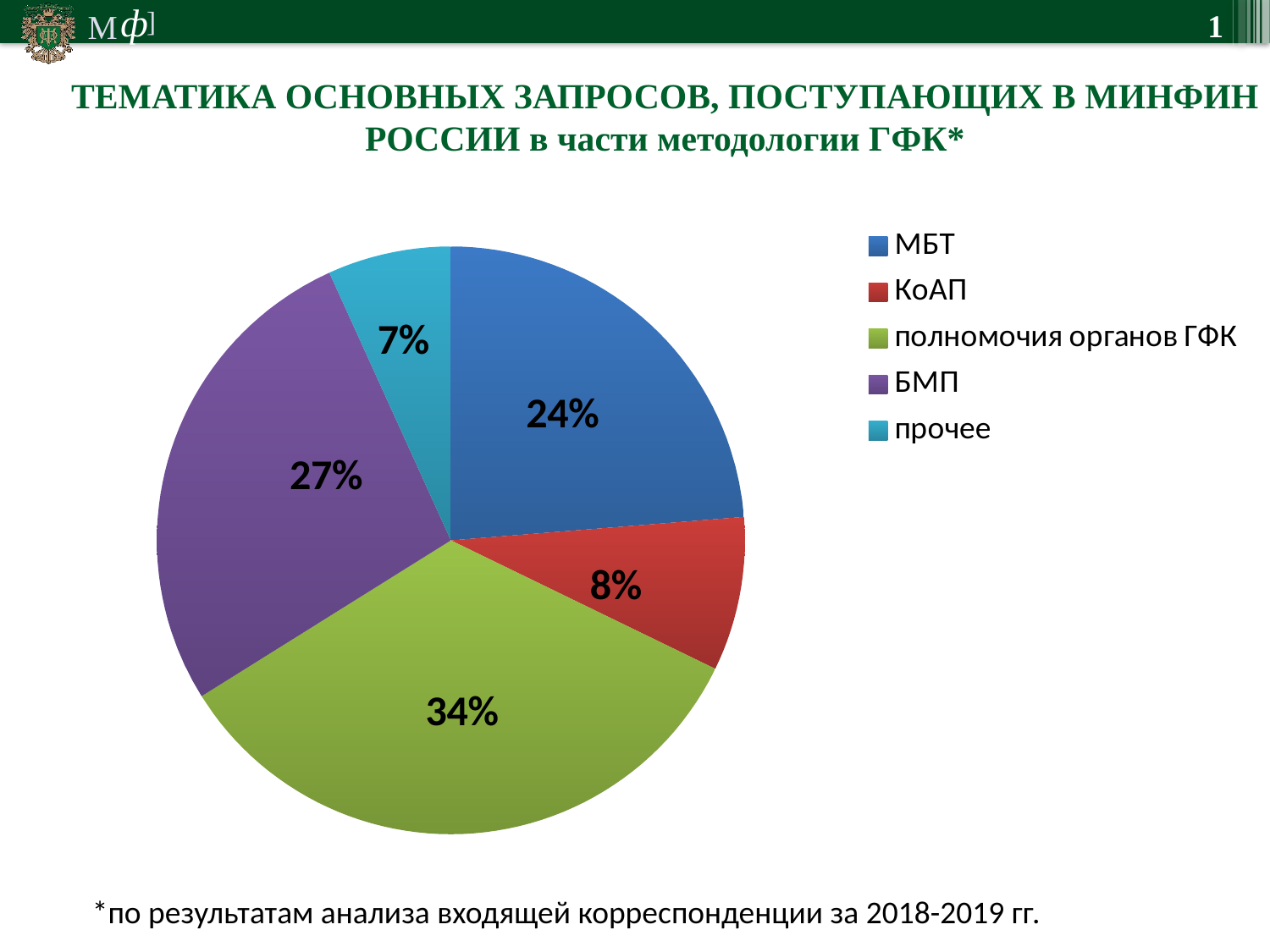
What is the difference in percentage points between полномочия органов ГФК and БМП? 7 Which is larger, the share for МБТ or the share for КоАП? МБТ Which category has the largest share of the pie? полномочия органов ГФК What share of the pie does полномочия органов ГФК account for? 34% What kind of chart is shown on the slide? pie chart What share of the pie does БМП account for? 27% How many categories are shown in the pie chart? 5 What share of the pie does МБТ account for? 24% What colour is the slice for БМП? purple What share of the pie does КоАП account for? 8% Which category has the smallest share of the pie? прочее What share of the pie does прочее account for? 7%